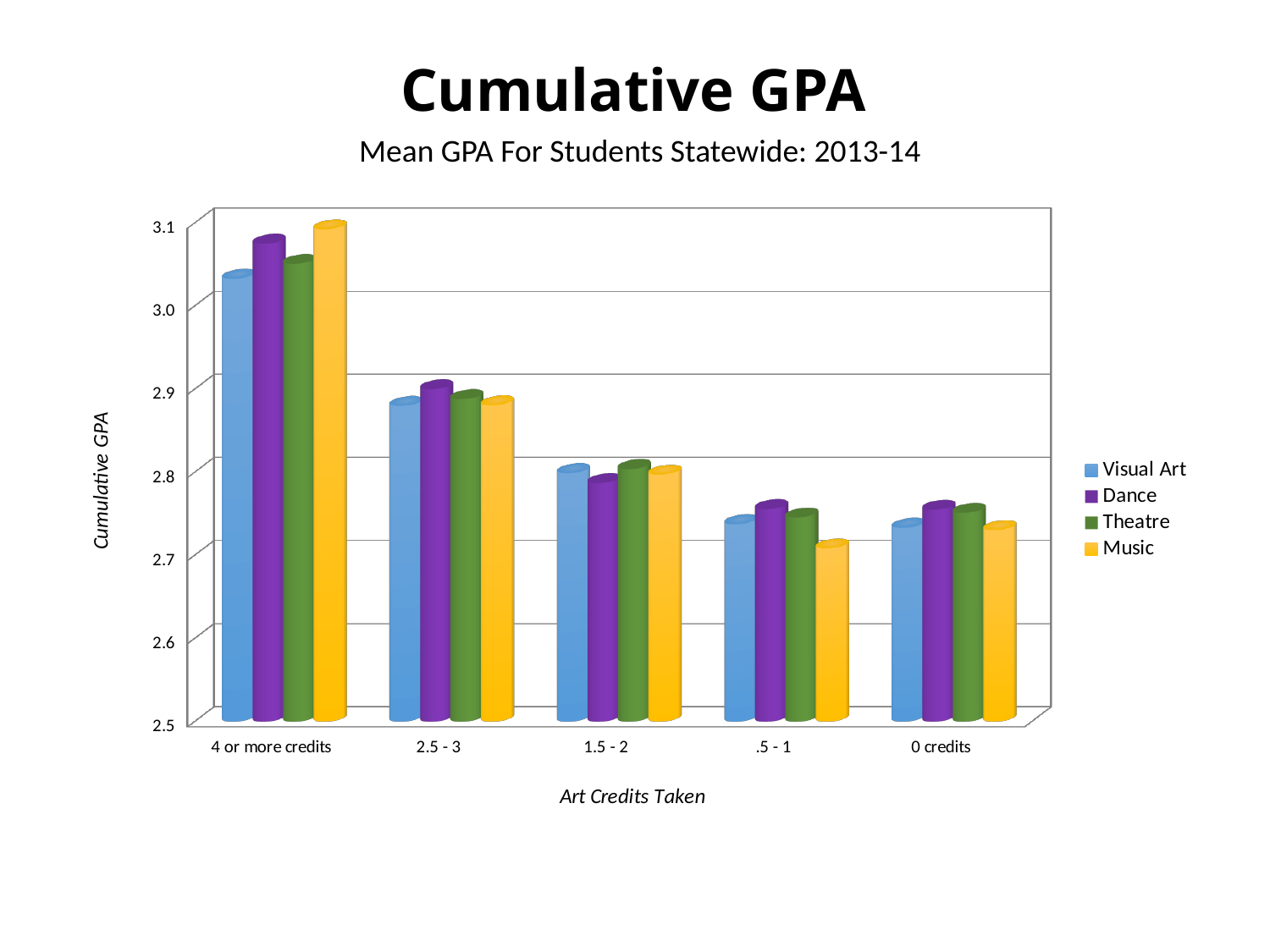
What kind of chart is shown on the slide? bar chart Is the Theatre value for '1.5 - 2' greater or less than 2.7? greater For which art-credit category is the Music bar highest? 4 or more credits Do the GPA values generally rise or fall moving from '4 or more credits' to '0 credits' along the x axis? fall Is the Visual Art value for '0 credits' greater or less than 2.8? less Is the Music value for '.5 - 1' greater or less than 2.8? less How many series does the legend list? 4 What is the title of the x axis? Art Credits Taken For '4 or more credits', which is larger: the Music value or the Visual Art value? Music How many art-credit categories are shown on the x axis? 5